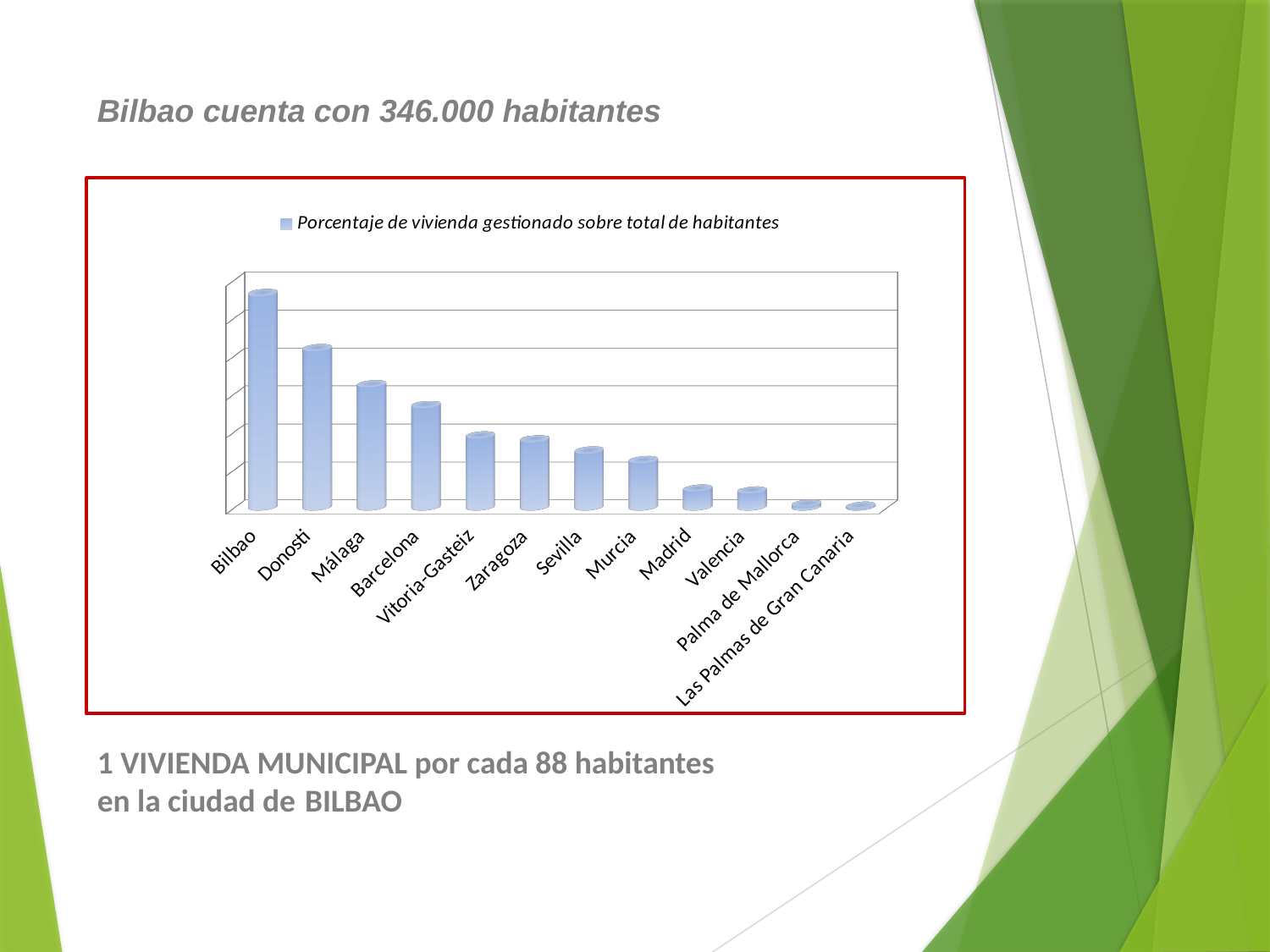
What is the name of the series shown in the chart legend? Porcentaje de vivienda gestionado sobre total de habitantes How many series does the chart legend list? 1 Which has a larger value, Bilbao or Donosti? Bilbao Do the values rise or fall moving from left to right along the x axis? fall Which has a larger value, Málaga or Sevilla? Málaga What kind of chart is shown on the slide? bar chart Which city has the highest value in the chart? Bilbao Which has a larger value, Murcia or Barcelona? Barcelona Which city is listed first on the x axis of the chart? Bilbao How many cities are shown on the x axis of the chart? 12